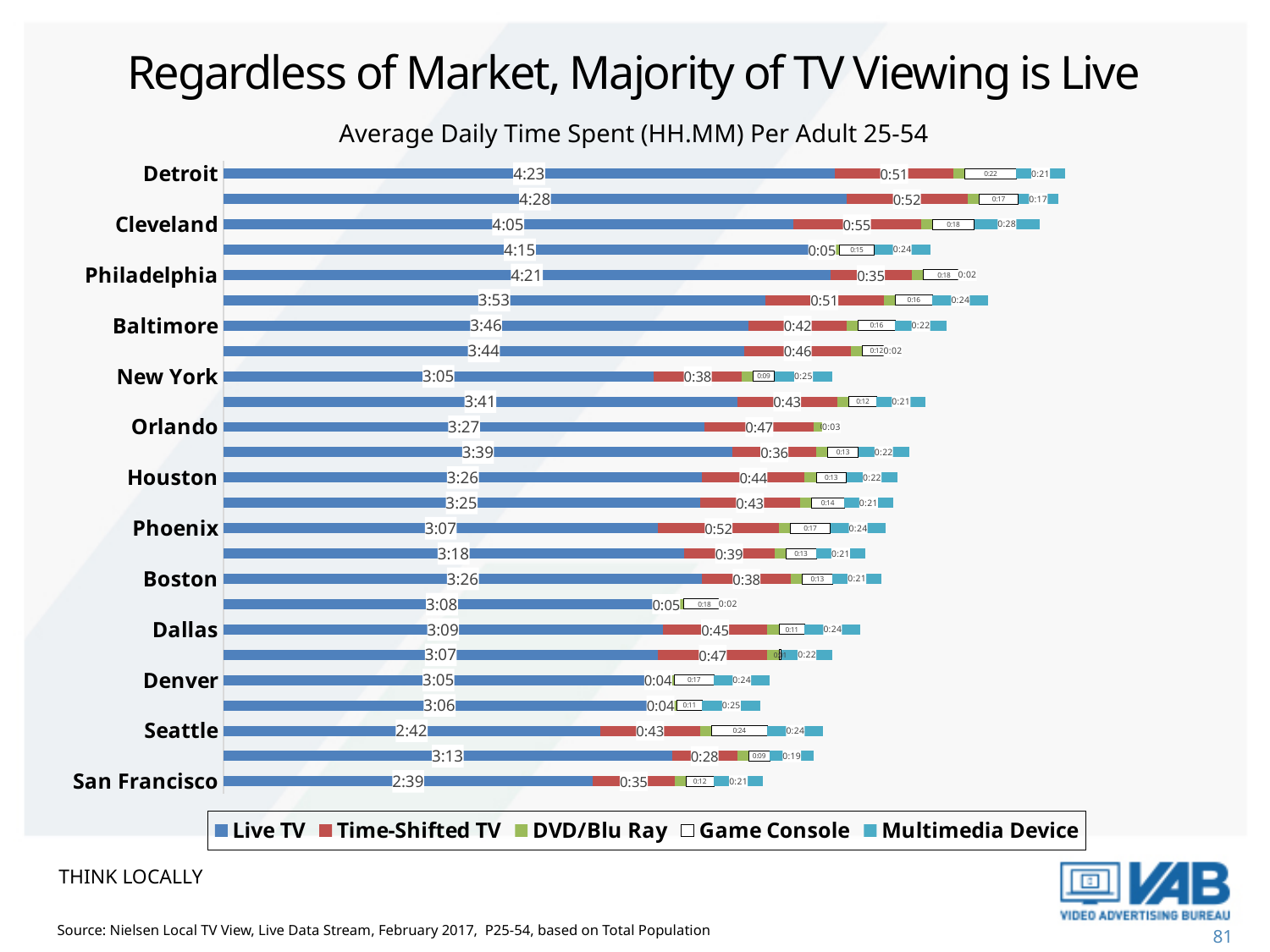
What is the difference between the Time-Shifted TV values for Cleveland and Detroit? 0:04 How many series does the legend list? 5 What is the Live TV value for Detroit? 4:23 Which series is shown in blue in the legend? Live TV Which labeled market has the lowest Live TV value? San Francisco What is the Multimedia Device value for New York? 0:25 What is the Time-Shifted TV value for Phoenix? 0:52 What is the Live TV value for San Francisco? 2:39 What type of chart is shown on the slide? Stacked bar chart What is the Time-Shifted TV value for Cleveland? 0:55 What is the subtitle of the chart? Average Daily Time Spent (HH.MM) Per Adult 25-54 Which has a higher Live TV value, Detroit or Cleveland? Detroit